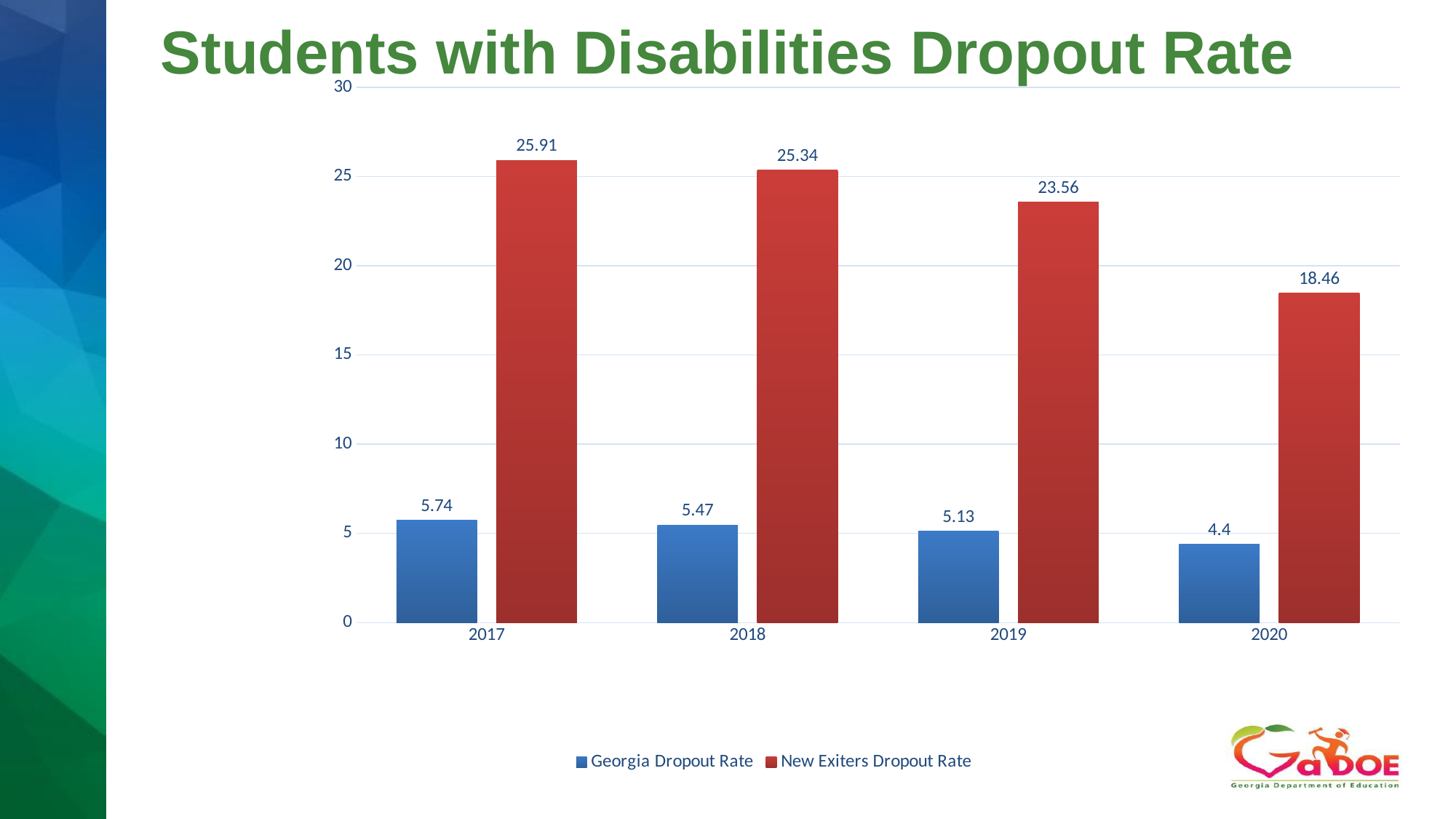
How many years are shown on the x axis? 4 In which year is the Georgia Dropout Rate lowest? 2020 In which year is the New Exiters Dropout Rate highest? 2017 What kind of chart is shown on the slide? bar chart What is the New Exiters Dropout Rate for 2019? 23.56 Does the Georgia Dropout Rate rise or fall from 2017 to 2020? fall What is the Georgia Dropout Rate for 2017? 5.74 Is the New Exiters Dropout Rate for 2020 greater or less than 20? less How many series does the legend list? 2 Which is larger in 2019, the Georgia Dropout Rate or the New Exiters Dropout Rate? New Exiters Dropout Rate What is the New Exiters Dropout Rate for 2020? 18.46 What is the difference between the New Exiters Dropout Rate and the Georgia Dropout Rate in 2018? 19.87